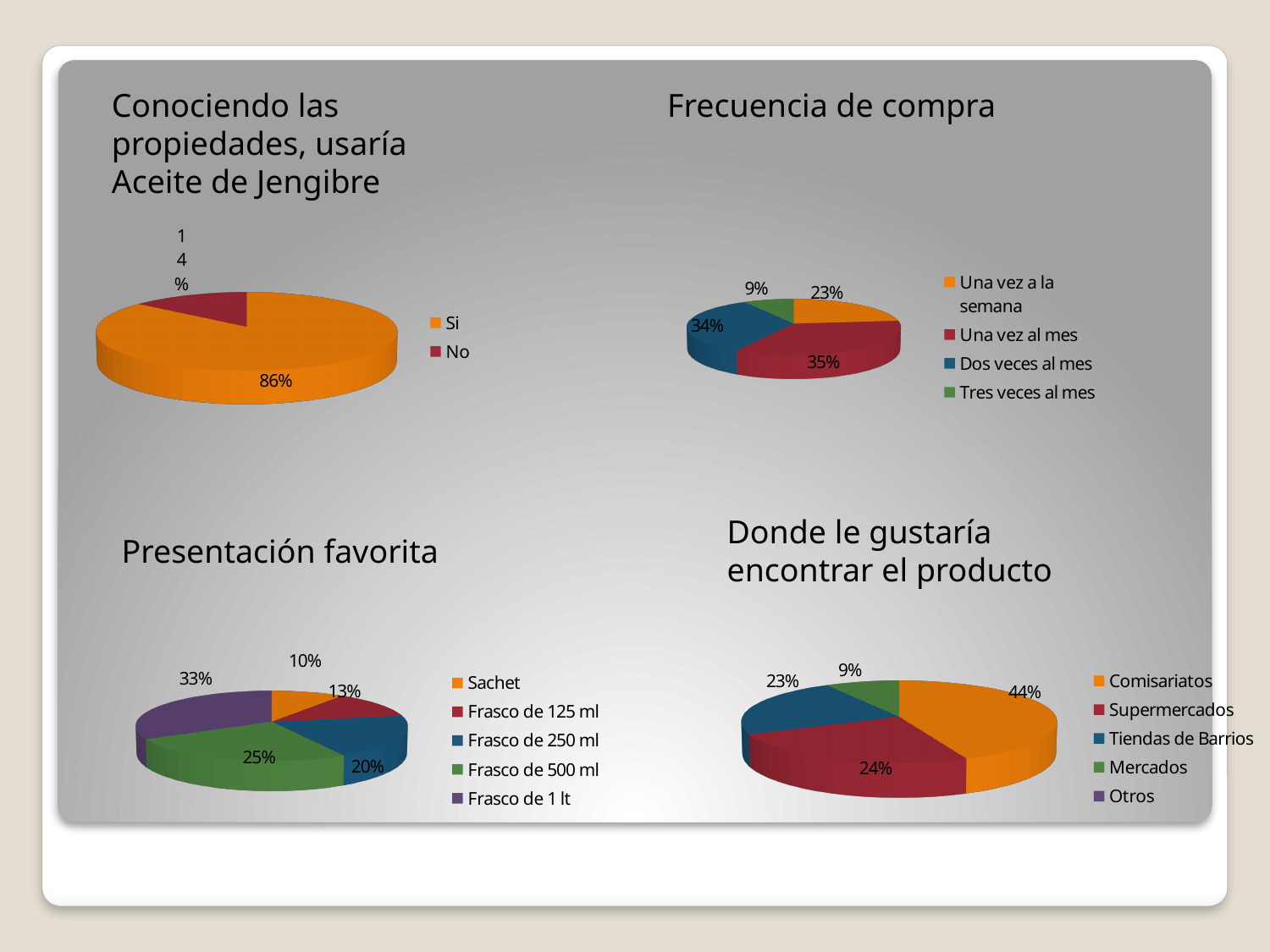
In the chart 'Donde le gustaría encontrar el producto', which is larger, 'Supermercados' or 'Tiendas de Barrios'? Supermercados In the chart 'Donde le gustaría encontrar el producto', what is the value for 'Comisariatos'? 44% What kind of chart is 'Frecuencia de compra'? Pie chart In the chart 'Frecuencia de compra', which category has the smallest slice? Tres veces al mes In the chart 'Frecuencia de compra', what is the value for 'Una vez a la semana'? 23% In the chart 'Presentación favorita', what is the difference between 'Frasco de 250 ml' and 'Sachet'? 10% In the chart 'Presentación favorita', what is the value for 'Frasco de 500 ml'? 25% In the chart 'Presentación favorita', which category has the largest slice? Frasco de 1 lt In the chart 'Conociendo las propiedades, usaría Aceite de Jengibre', what share of the pie is 'Si'? 86% In the chart 'Donde le gustaría encontrar el producto', how many entries does the legend list? 5 In the chart 'Conociendo las propiedades, usaría Aceite de Jengibre', what share of the pie is 'No'? 14% In the chart 'Frecuencia de compra', how many categories does the legend list? 4